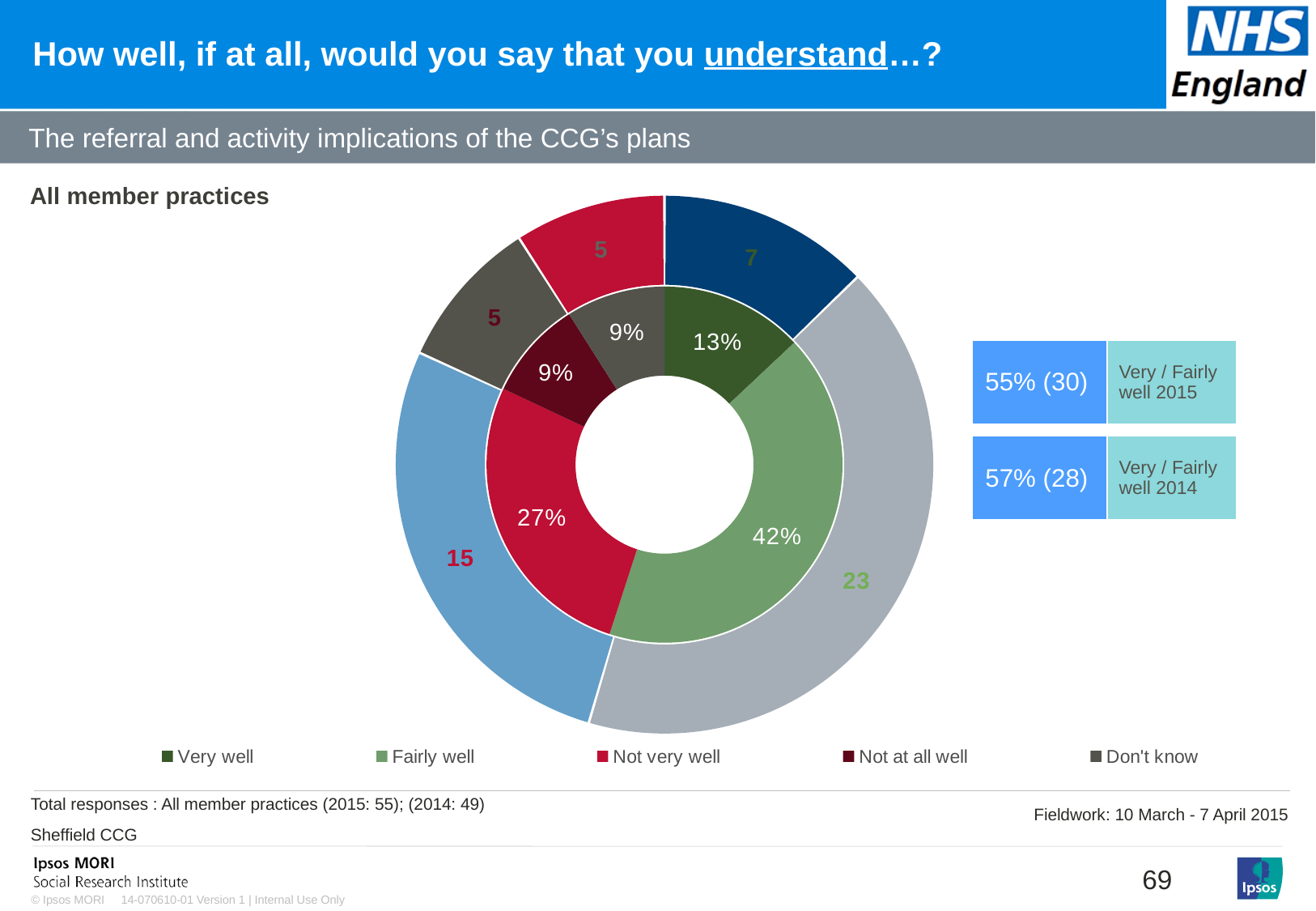
How many member practices (count shown on the outer ring) answered 'Fairly well'? 23 What is the combined 'Very / Fairly well' percentage for 2015 shown in the box beside the chart? 55% (30) What type of chart is shown on the slide? Doughnut chart What percentage of member practices answered 'Not at all well'? 9% Which is larger, the share for 'Very well' or the share for 'Not very well'? Not very well Which response category has the largest share of the doughnut chart? Fairly well What percentage of member practices answered 'Not very well'? 27% What is the difference in percentage points between 'Fairly well' and 'Not very well'? 15 What percentage of member practices said they understand the referral and activity implications of the CCG's plans 'Fairly well'? 42% What percentage of member practices answered 'Very well'? 13% How many member practices (count shown on the outer ring) answered 'Not very well'? 15 How many response categories does the legend list? 5